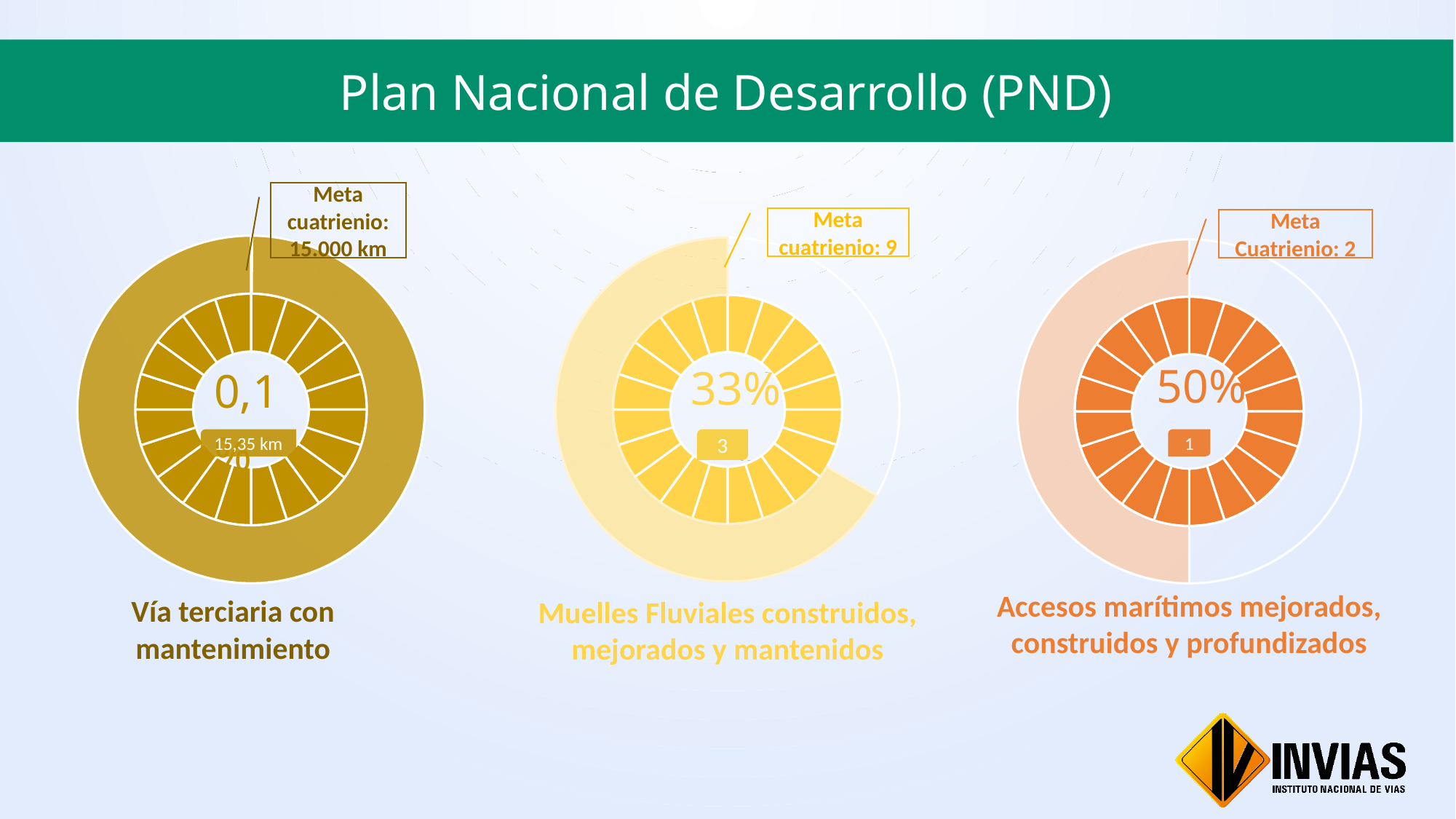
How many donut charts are shown on the slide? 3 Which chart shows the higher percentage, 'Muelles Fluviales' or 'Accesos marítimos'? Accesos marítimos What is the title of the slide? Plan Nacional de Desarrollo (PND) What percentage is shown in the centre of the 'Accesos marítimos mejorados, construidos y profundizados' chart? 50% What is the 'Meta Cuatrienio' for the 'Accesos marítimos mejorados, construidos y profundizados' chart? 2 In the 'Muelles Fluviales' chart, how many more are needed to reach the Meta cuatrienio of 9 from the achieved value of 3? 6 Which of the three charts shows the highest percentage of progress? Accesos marítimos mejorados, construidos y profundizados What is the 'Meta cuatrienio' shown for the 'Vía terciaria con mantenimiento' chart? 15.000 km What number is shown in the small box below the percentage in the 'Muelles Fluviales' chart? 3 What is the 'Meta cuatrienio' for the 'Muelles Fluviales construidos, mejorados y mantenidos' chart? 9 What percentage is shown in the centre of the 'Muelles Fluviales construidos, mejorados y mantenidos' chart? 33% What value in km is shown inside the 'Vía terciaria con mantenimiento' chart? 15,35 km